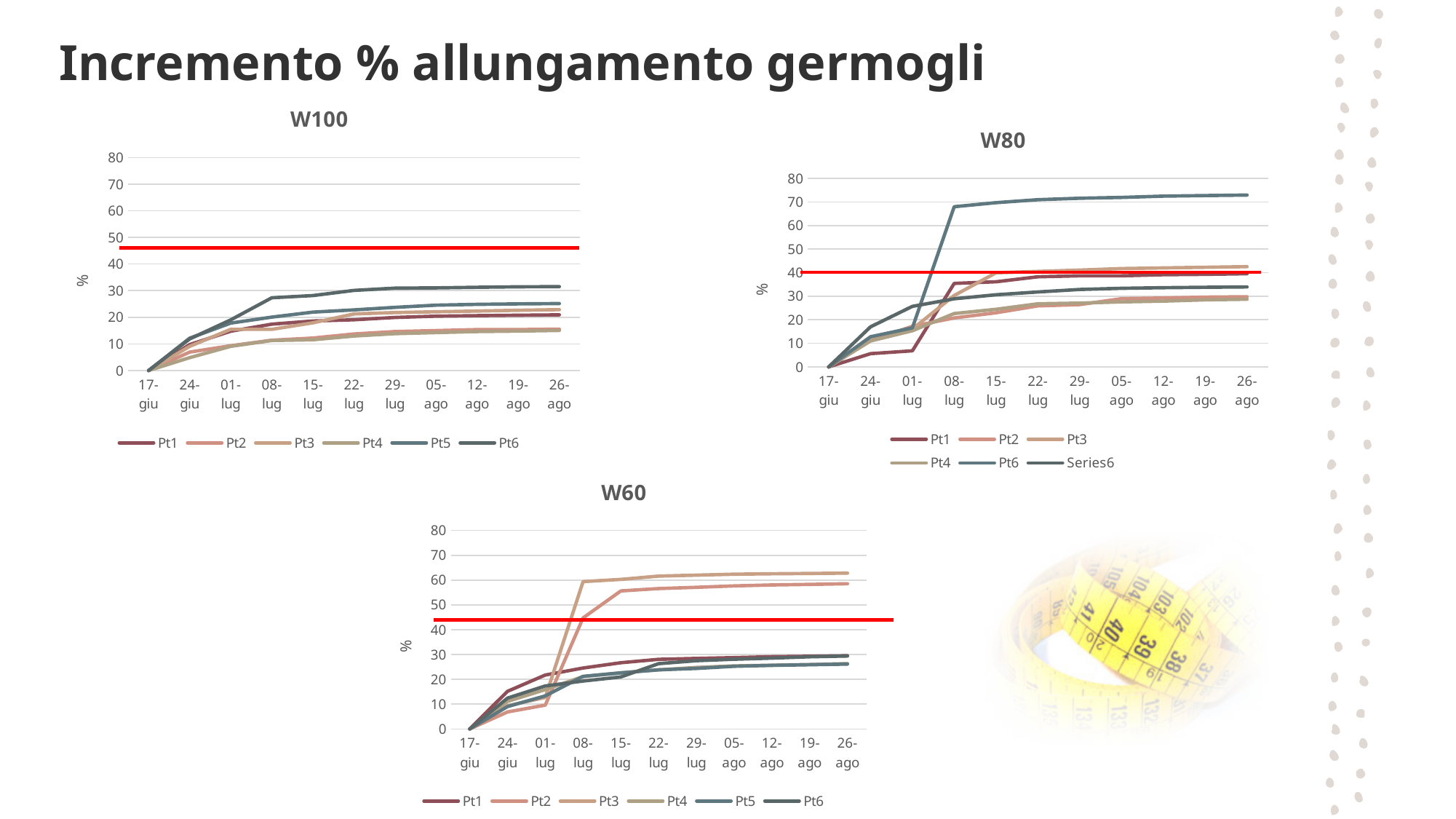
In the W60 chart, which series has the highest value at 26-ago? Pt3 In the W80 chart, is the value for Series6 at 26-ago greater or less than 40? less How many series does the legend of the W100 chart list? 6 In the W60 chart, is the value for Pt5 at 26-ago greater or less than 30? less How many dates are shown on the x axis of the W60 chart? 11 In the W100 chart, is the value for Pt5 at 26-ago greater or less than 30? less What is the last legend entry of the W80 chart? Series6 In the W80 chart, which series has the highest value at 26-ago? Pt6 In the W60 chart, do the values for Pt3 rise or fall from 17-giu to 26-ago? rise What kind of chart is the W100 chart? line chart In the W100 chart, which series has the highest value at 26-ago? Pt6